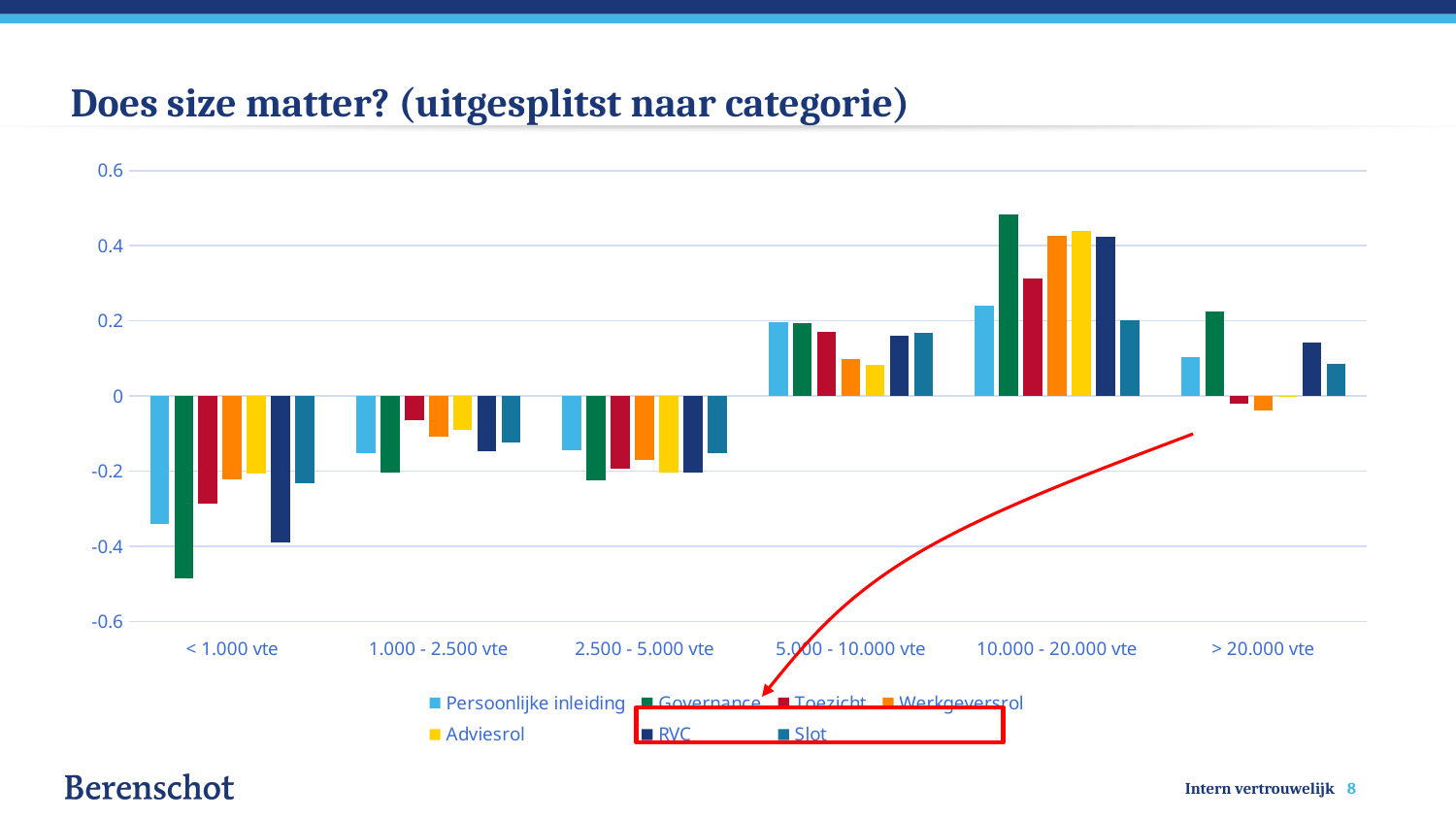
Is the Governance value for < 1.000 vte greater or less than -0.4? less What kind of chart is shown on the slide? Bar chart Is the Governance value for 10.000 - 20.000 vte greater or less than 0.4? greater Which series has the lowest value in the < 1.000 vte category? Governance Is the Toezicht value for 10.000 - 20.000 vte greater or less than 0.2? greater How many series does the legend list? 7 How many size categories are shown on the x axis? 6 In the > 20.000 vte category, which is larger: Governance or Persoonlijke inleiding? Governance What is the title of the chart slide? Does size matter? (uitgesplitst naar categorie) Do the Governance values rise or fall from < 1.000 vte to 10.000 - 20.000 vte? rise In which size category does the Governance series reach its highest value? 10.000 - 20.000 vte